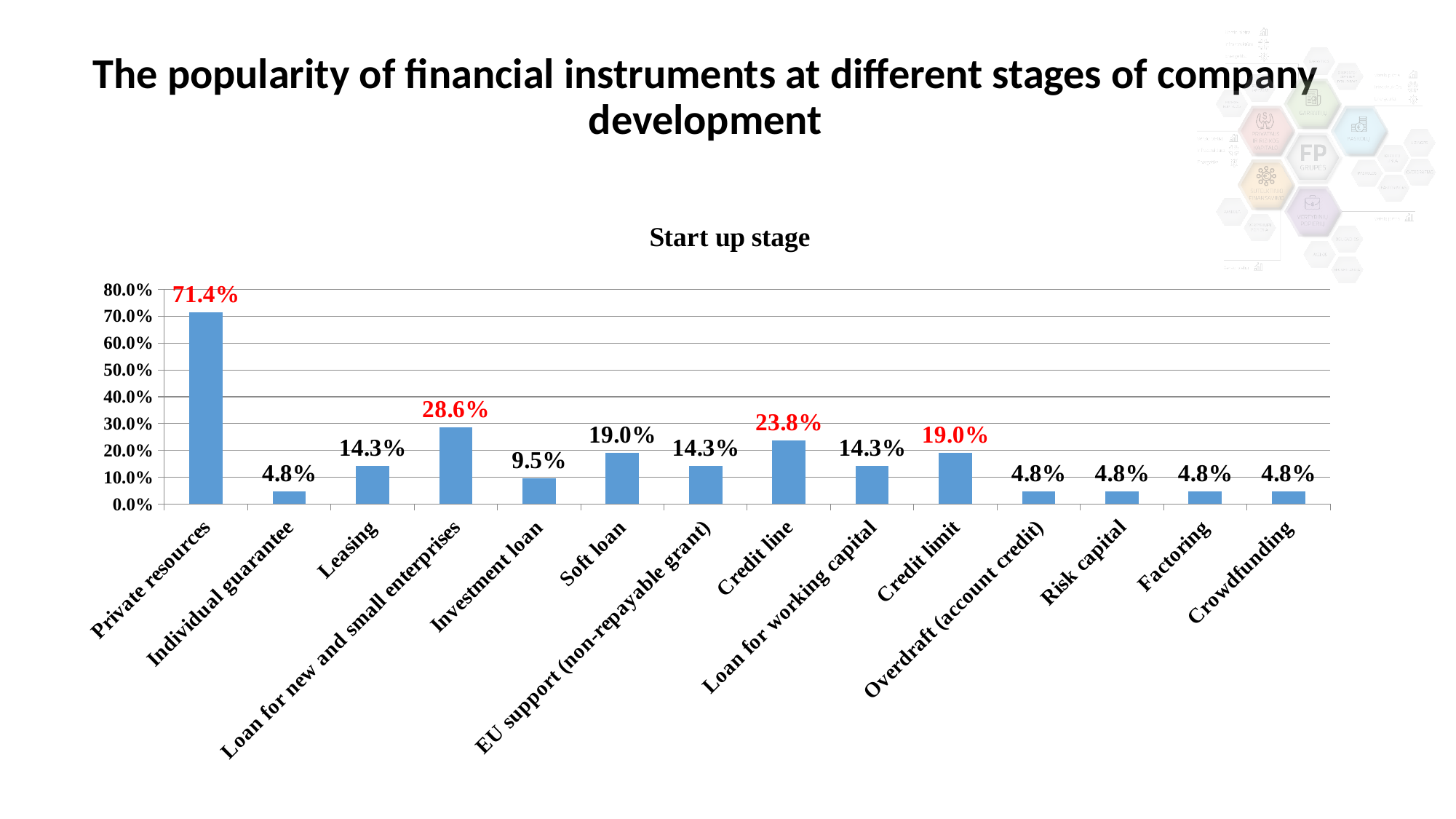
Which is larger, the value for Leasing or the value for Credit limit? Credit limit What is the value for Private resources? 71.4% Which category has the highest value? Private resources What is the difference between the values for Private resources and Loan for new and small enterprises? 42.8% How many categories are shown on the x axis? 14 What is the value for Investment loan? 9.5% What is the value for Credit line? 23.8% What is the difference between the values for Credit line and Soft loan? 4.8% What is the value for Loan for new and small enterprises? 28.6% What is the title of the chart? Start up stage What kind of chart is shown on the slide? Bar chart Is the value for Private resources greater or less than 70.0%? greater